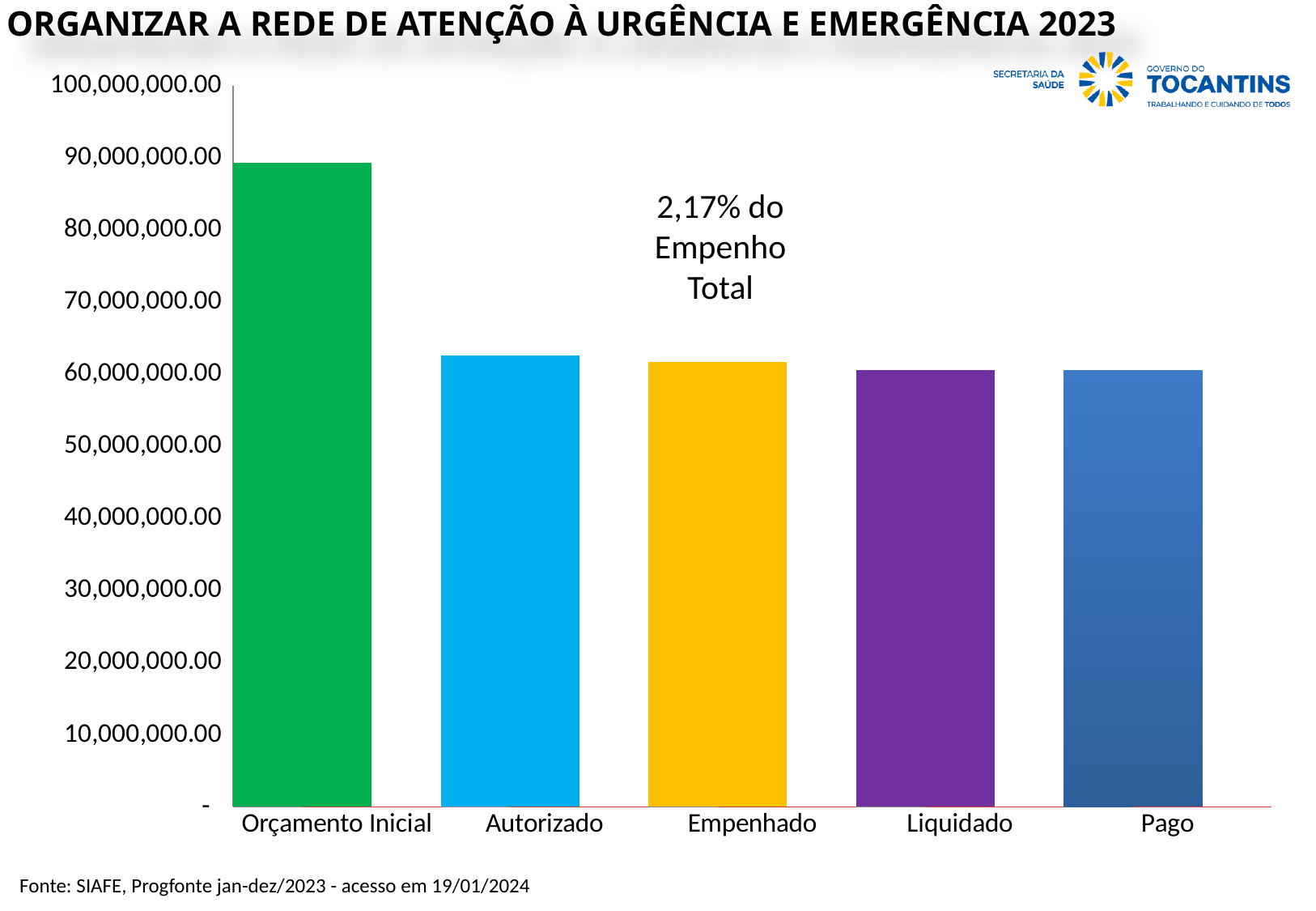
Is the value for Orçamento Inicial greater or less than 80,000,000.00? greater Which category has the highest value in the chart? Orçamento Inicial Which is larger, the value for Orçamento Inicial or the value for Empenhado? Orçamento Inicial Is the value for Orçamento Inicial greater or less than 100,000,000.00? less Is the value for Autorizado greater or less than 70,000,000.00? less How many categories are plotted on the x axis of the chart? 5 Do the values generally rise or fall from left to right along the x axis? fall What percentage of the total commitment (Empenho Total) does the annotation on the chart state? 2,17% What kind of chart is shown on the slide? bar chart